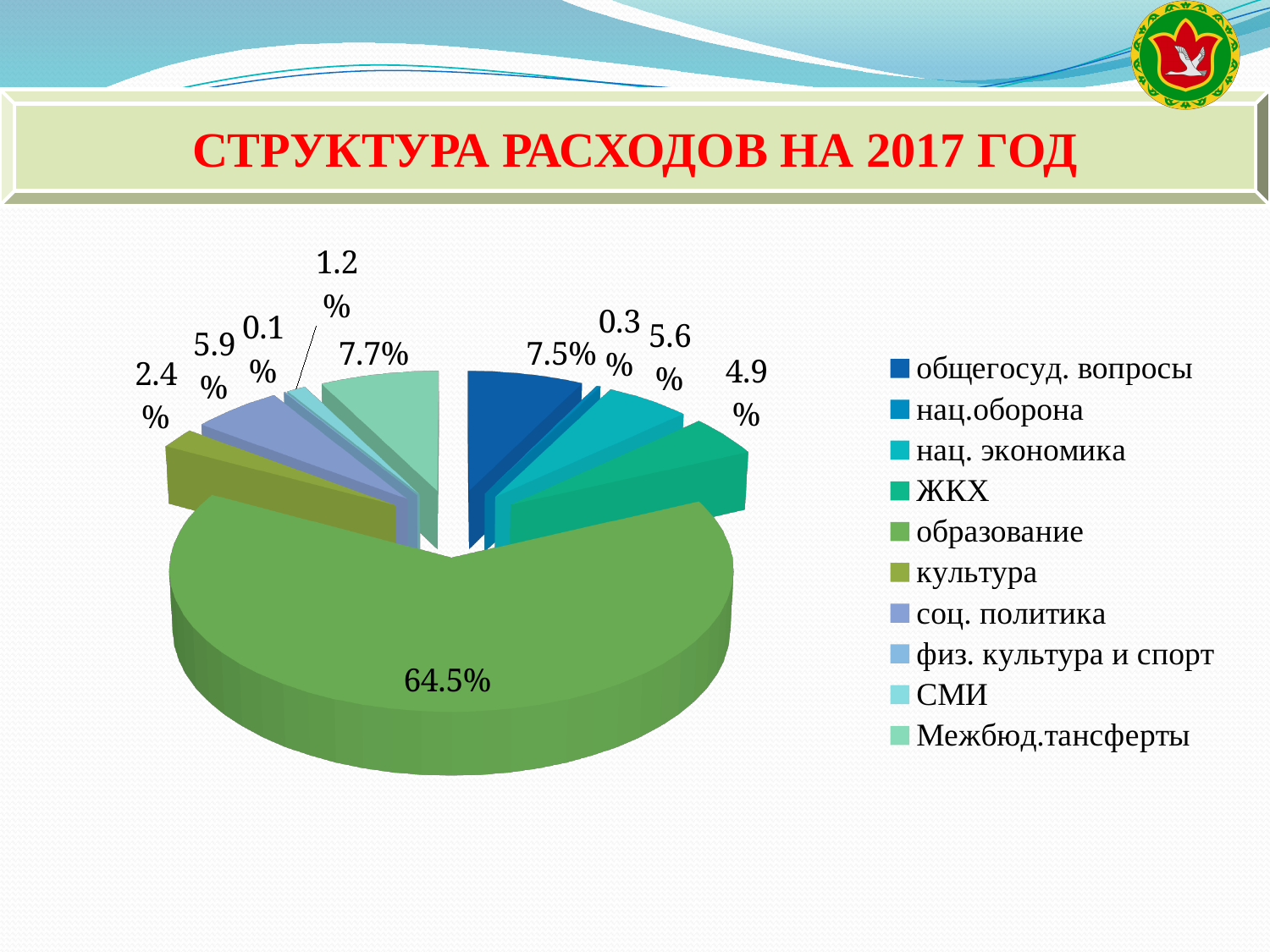
What percentage is shown for Межбюд.тансферты? 7.7% What is the share for соц. политика? 5.9% What is the difference between the shares of Межбюд.тансферты and общегосуд. вопросы? 0.2% Which category has the smallest share of the pie? физ. культура и спорт What is the value for ЖКХ? 4.9% What is the title of the slide? СТРУКТУРА РАСХОДОВ НА 2017 ГОД What type of chart is shown on the slide? pie chart What is the value shown for общегосуд. вопросы? 7.5% How many categories does the legend list? 10 Which is larger, the share for нац. экономика or the share for ЖКХ? нац. экономика What share of expenditures does образование account for? 64.5% Which category has the largest share of the pie? образование